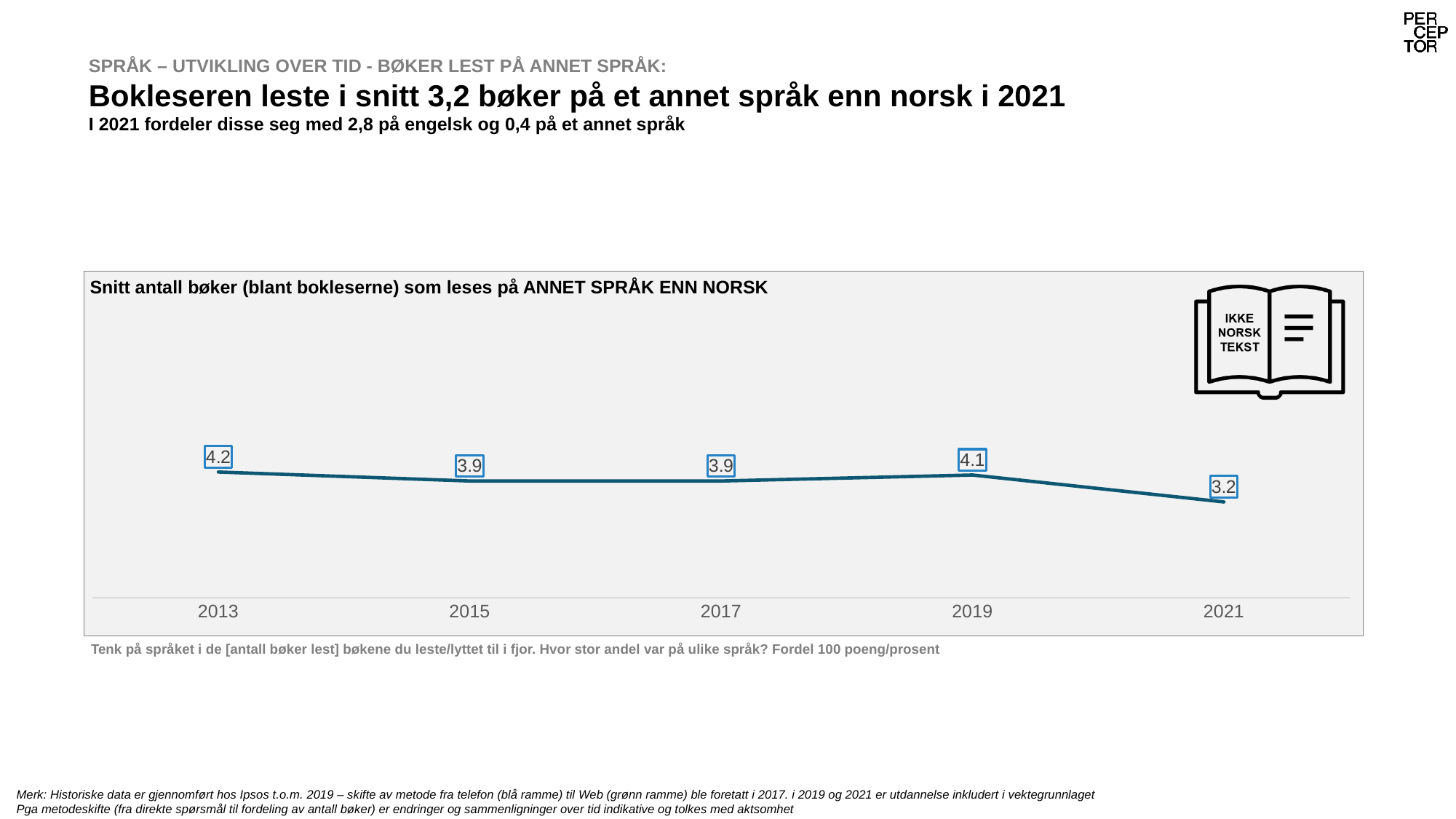
What is the value for 2013? 4.2 What is the difference between the values for 2019 and 2021? 0.9 What is the value for 2021? 3.2 Do the values rise or fall from 2019 to 2021? Fall Which year has the lowest value? 2021 What is the title of the chart? Snitt antall bøker (blant bokleserne) som leses på ANNET SPRÅK ENN NORSK Which is larger, the value for 2017 or the value for 2019? 2019 How many years are plotted on the chart? 5 What is the value for 2015? 3.9 What kind of chart is shown? Line chart Which year has the highest value? 2013 What is the value for 2019? 4.1